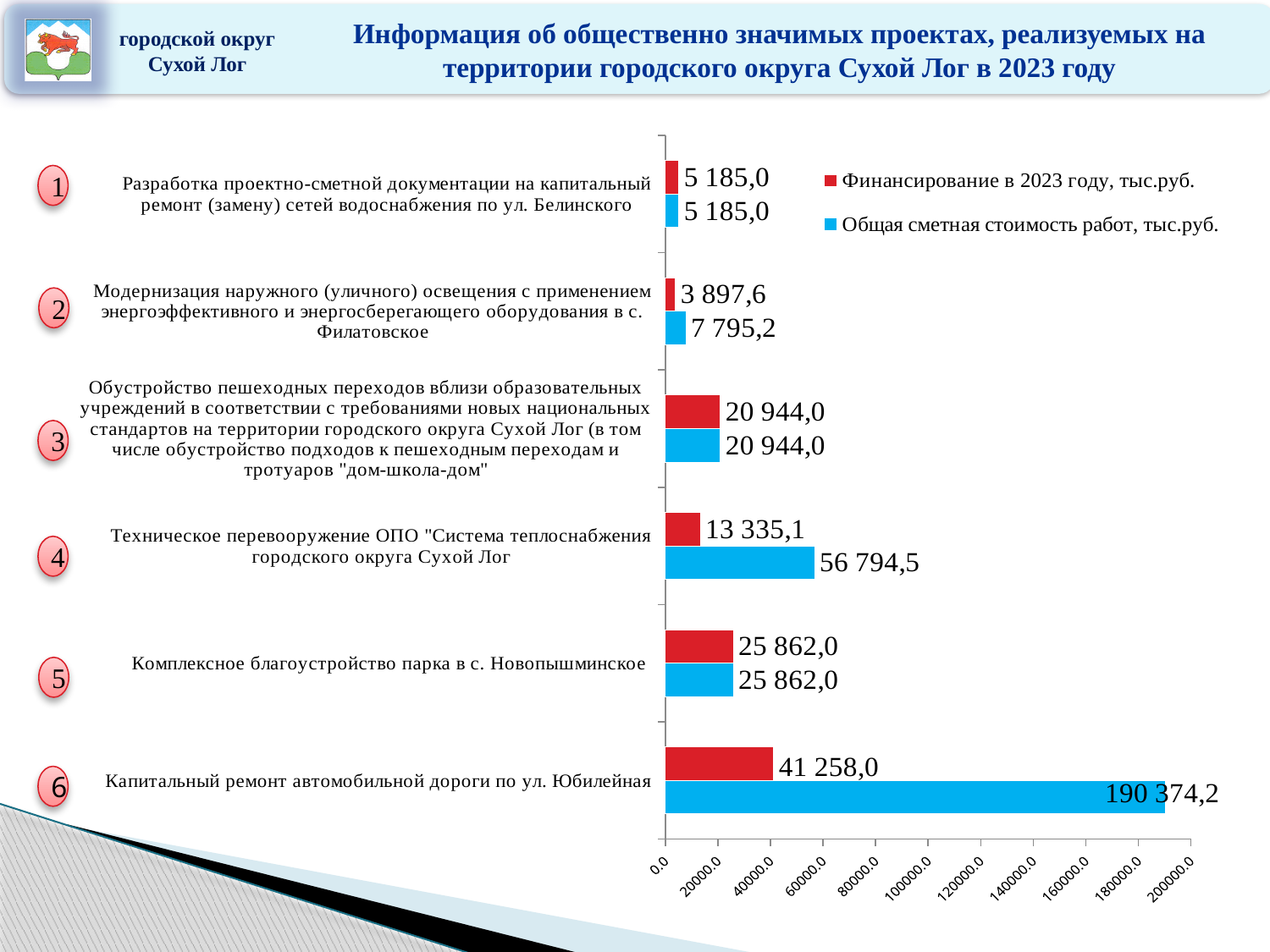
How many series does the chart legend list? 2 What type of chart is shown on the slide? Bar chart Is the value of "Общая сметная стоимость работ" for "Капитальный ремонт автомобильной дороги по ул. Юбилейная" greater or less than 180000,0? greater Which project has the highest "Общая сметная стоимость работ, тыс.руб."? Капитальный ремонт автомобильной дороги по ул. Юбилейная What is the difference between "Общая сметная стоимость работ" and "Финансирование в 2023 году" for "Техническое перевооружение ОПО "Система теплоснабжения городского округа Сухой Лог"? 43 459,4 What is the difference between "Общая сметная стоимость работ" and "Финансирование в 2023 году" for "Капитальный ремонт автомобильной дороги по ул. Юбилейная"? 149 116,2 Which is larger: "Финансирование в 2023 году" for "Комплексное благоустройство парка в с. Новопышминское" or for "Обустройство пешеходных переходов вблизи образовательных учреждений..."? Комплексное благоустройство парка в с. Новопышминское What is the value of "Финансирование в 2023 году, тыс.руб." for "Модернизация наружного (уличного) освещения ... в с. Филатовское"? 3 897,6 How many projects (categories) are shown in the chart? 6 What is the value of "Финансирование в 2023 году, тыс.руб." for "Капитальный ремонт автомобильной дороги по ул. Юбилейная"? 41 258,0 Which project has the lowest "Финансирование в 2023 году, тыс.руб."? Модернизация наружного (уличного) освещения с применением энергоэффективного и энергосберегающего оборудования в с. Филатовское What is the value of "Общая сметная стоимость работ, тыс.руб." for "Техническое перевооружение ОПО "Система теплоснабжения городского округа Сухой Лог"? 56 794,5